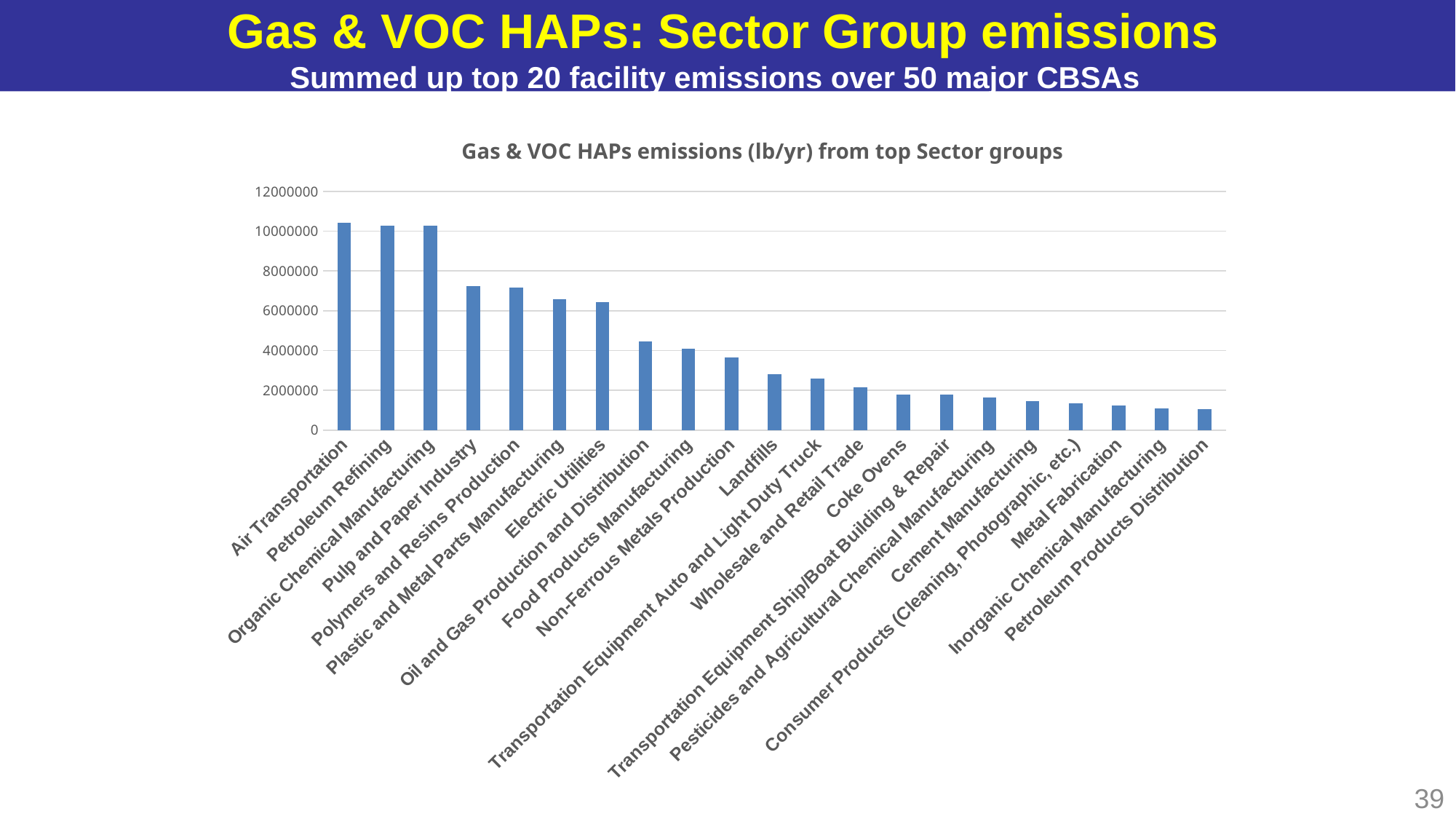
What is the title of the chart? Gas & VOC HAPs emissions (lb/yr) from top Sector groups Is the value for Pulp and Paper Industry greater or less than 6000000? greater What kind of chart is shown on the slide? Bar chart Is the value for Coke Ovens greater or less than 2000000? less Which has higher emissions, Pulp and Paper Industry or Landfills? Pulp and Paper Industry How many sector groups are plotted on the chart? 21 Do the bar values rise or fall from left to right across the chart? Fall Is the value for Air Transportation greater or less than 10000000? greater Which sector group has the highest Gas & VOC HAPs emissions? Air Transportation